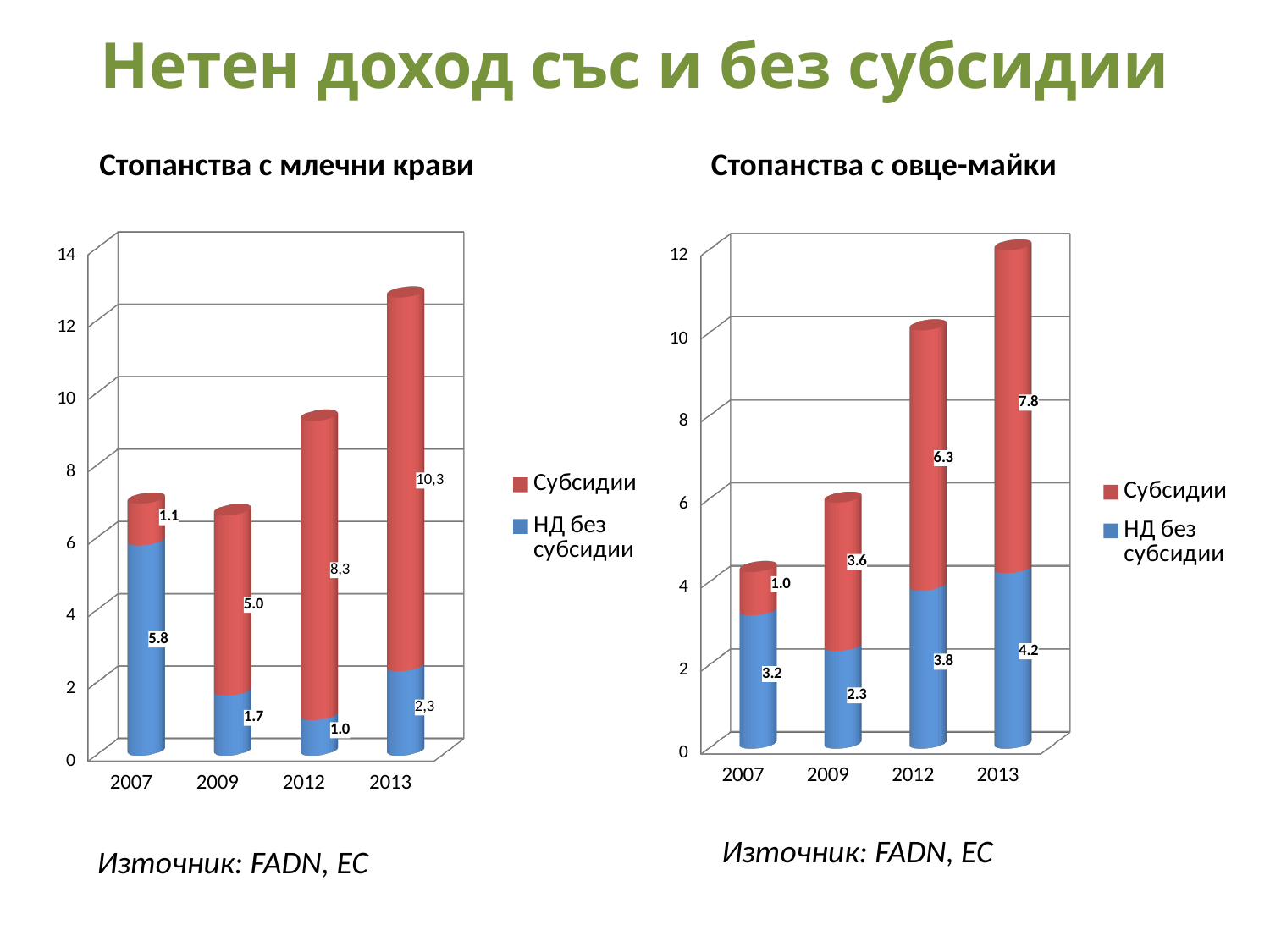
In the chart titled 'Стопанства с овце-майки', what is the value of 'Субсидии' for 2012? 6.3 In the chart titled 'Стопанства с млечни крави', what is the value of 'НД без субсидии' for 2007? 5.8 In the chart titled 'Стопанства с млечни крави', what is the value of 'Субсидии' for 2013? 10,3 What kind of chart is the chart titled 'Стопанства с овце-майки'? Stacked bar chart In the chart titled 'Стопанства с овце-майки', what is the value of 'НД без субсидии' for 2009? 2.3 In the chart titled 'Стопанства с овце-майки', which year has the highest value for 'Субсидии'? 2013 In the chart titled 'Стопанства с млечни крави', which is larger for 2009: 'Субсидии' or 'НД без субсидии'? Субсидии How many series does the legend of the chart titled 'Стопанства с овце-майки' list? 2 How many years are shown on the x axis of the chart titled 'Стопанства с млечни крави'? 4 In the chart titled 'Стопанства с млечни крави', which year has the lowest value for 'НД без субсидии'? 2012 In the chart titled 'Стопанства с овце-майки', what is the difference between the 'Субсидии' values for 2013 and 2007? 6.8 In the chart titled 'Стопанства с овце-майки', what is the total of the stacked bar for 2013? 12.0